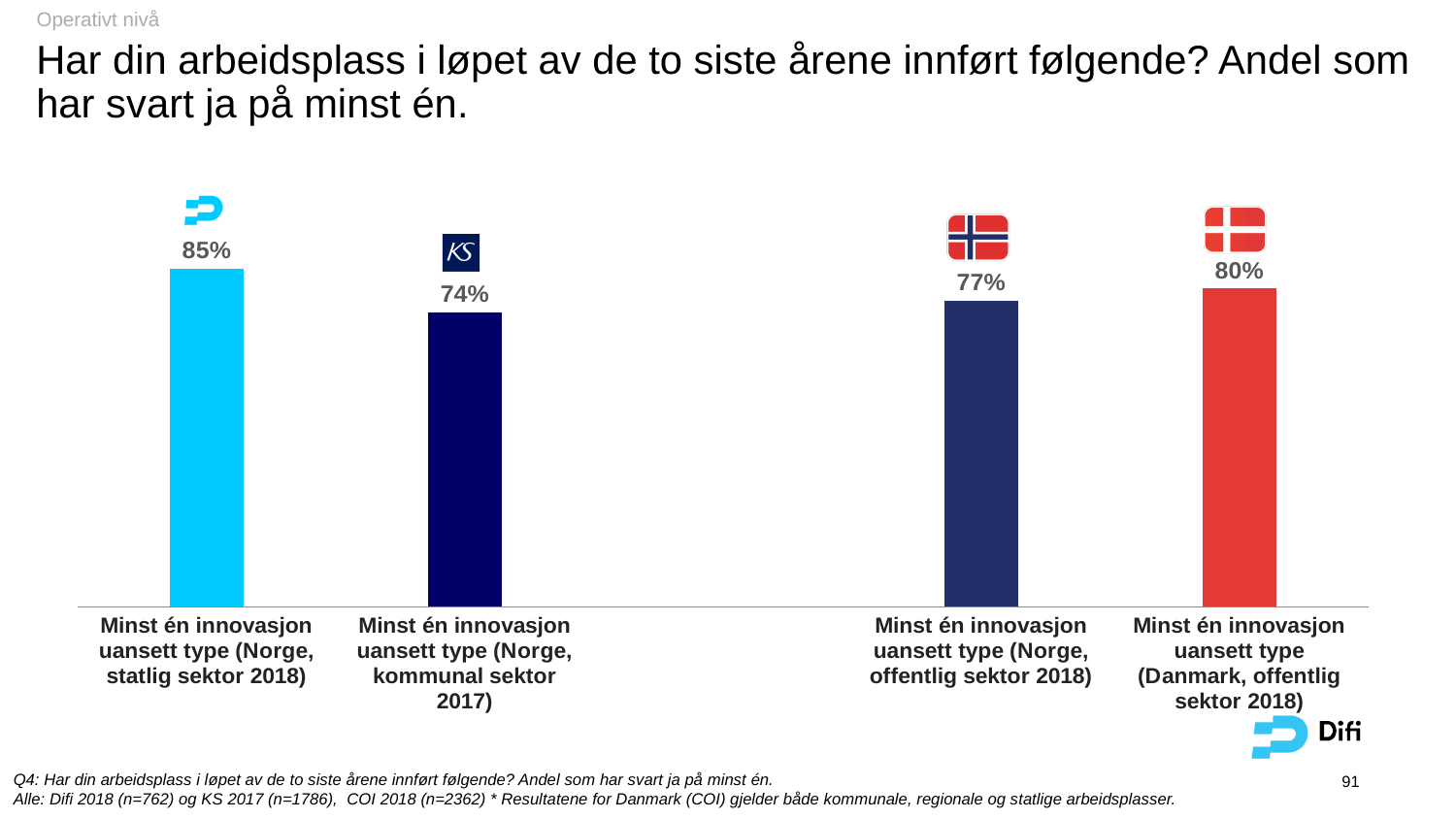
What colour is the bar for Danmark, offentlig sektor 2018? Red What is the value for 'Minst én innovasjon uansett type (Norge, kommunal sektor 2017)'? 74% How many bars are shown in the chart? 4 What is the difference between the value for Norge, statlig sektor 2018 and Norge, kommunal sektor 2017? 11% What is the difference between the value for Danmark, offentlig sektor 2018 and Norge, offentlig sektor 2018? 3% Which category has the lowest value? Minst én innovasjon uansett type (Norge, kommunal sektor 2017) Which is larger: the value for Norge, offentlig sektor 2018 or Danmark, offentlig sektor 2018? Danmark, offentlig sektor 2018 What kind of chart is shown on the slide? Bar chart What is the value for 'Minst én innovasjon uansett type (Danmark, offentlig sektor 2018)'? 80% What is the value for 'Minst én innovasjon uansett type (Norge, statlig sektor 2018)'? 85% Which category has the highest value? Minst én innovasjon uansett type (Norge, statlig sektor 2018) What is the value for 'Minst én innovasjon uansett type (Norge, offentlig sektor 2018)'? 77%